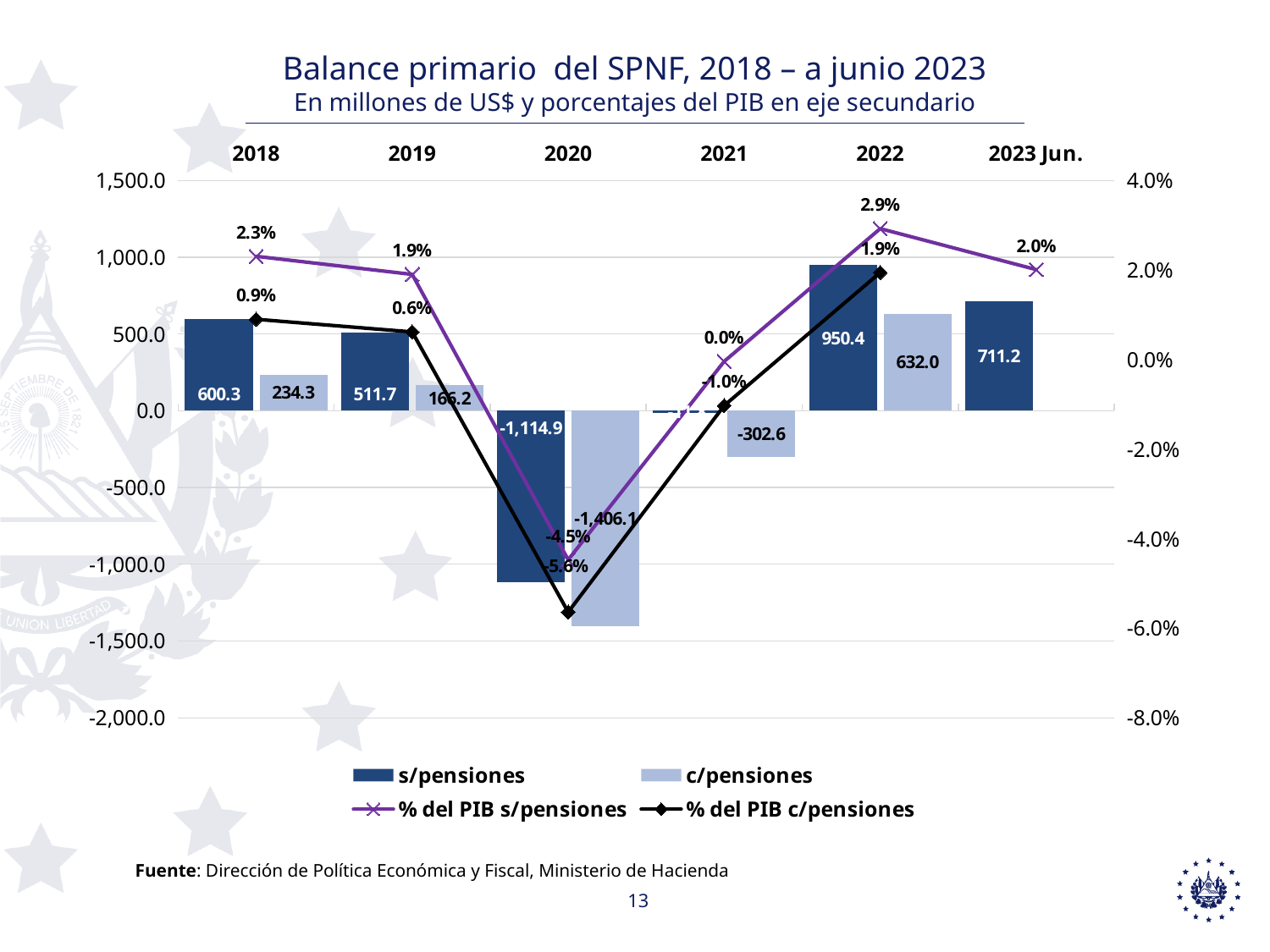
What is the % del PIB s/pensiones value for 2022? 2.9% How many series does the legend list? 4 What is the value of c/pensiones for 2020? -1,406.1 What is the % del PIB c/pensiones value for 2020? -5.6% What kind of chart is shown on the slide? Combined bar and line chart How many time periods are shown on the x axis? 6 What is the value of s/pensiones for 2018? 600.3 In which year is the s/pensiones bar highest? 2022 In 2019, which is larger: s/pensiones or c/pensiones? s/pensiones What is the difference between the s/pensiones values for 2022 and 2023 Jun.? 239.2 In which year is the c/pensiones bar lowest? 2020 What is the title of the chart? Balance primario del SPNF, 2018 – a junio 2023